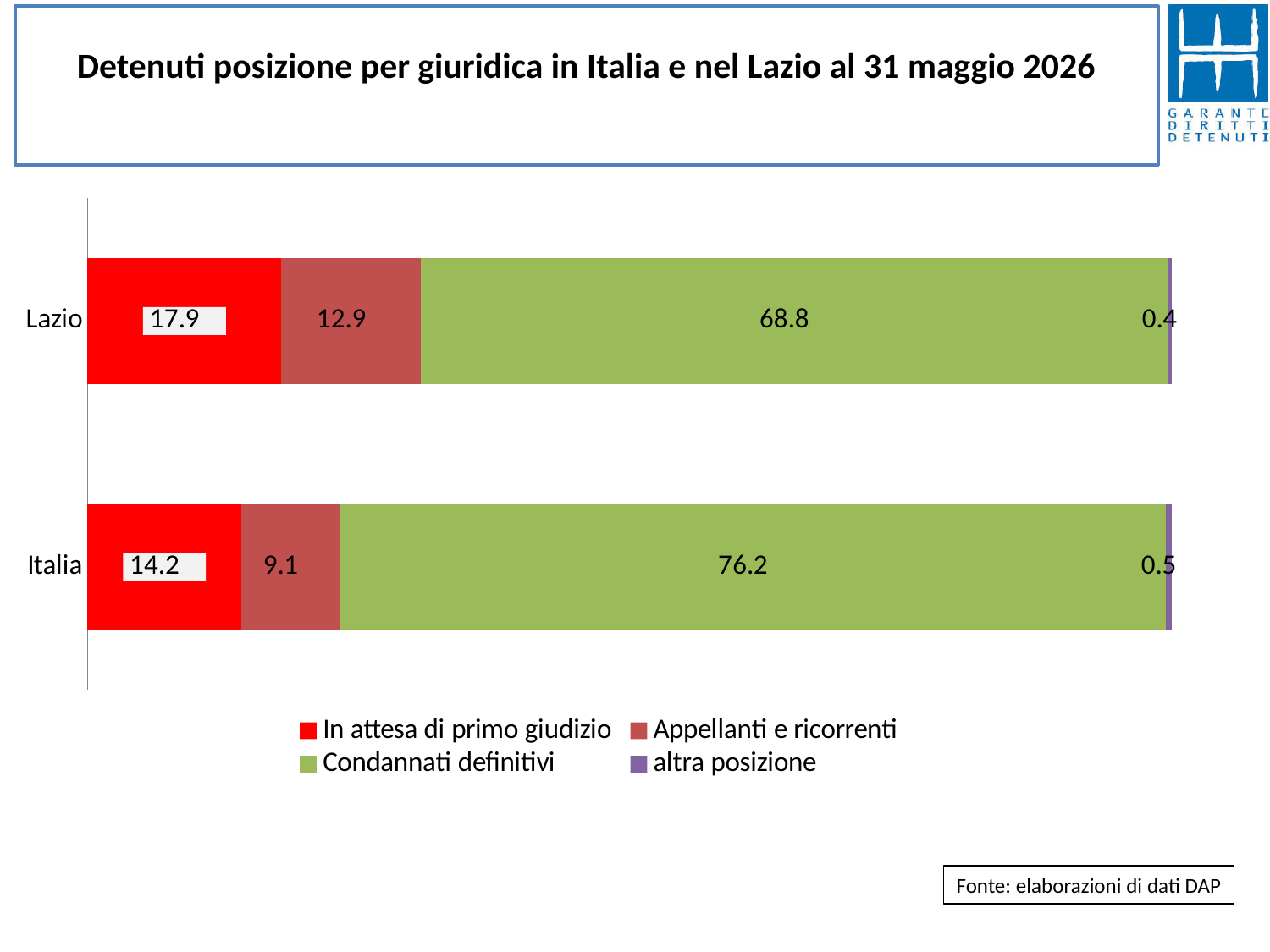
What kind of chart is shown on the slide? Stacked bar chart What is the difference between the 'Condannati definitivi' values for Italia and Lazio? 7.4 How many categories are shown on the y axis? 2 What is the value for 'Appellanti e ricorrenti' for Lazio? 12.9 What is the value for 'Condannati definitivi' for Italia? 76.2 Which category has the higher value for 'In attesa di primo giudizio', Lazio or Italia? Lazio Which series is shown in green in the legend? Condannati definitivi What is the value for 'In attesa di primo giudizio' for Lazio? 17.9 Which category has the higher value for 'Condannati definitivi', Lazio or Italia? Italia What is the value for 'altra posizione' for Italia? 0.5 What is the difference between the 'Appellanti e ricorrenti' values for Lazio and Italia? 3.8 How many series does the legend list? 4